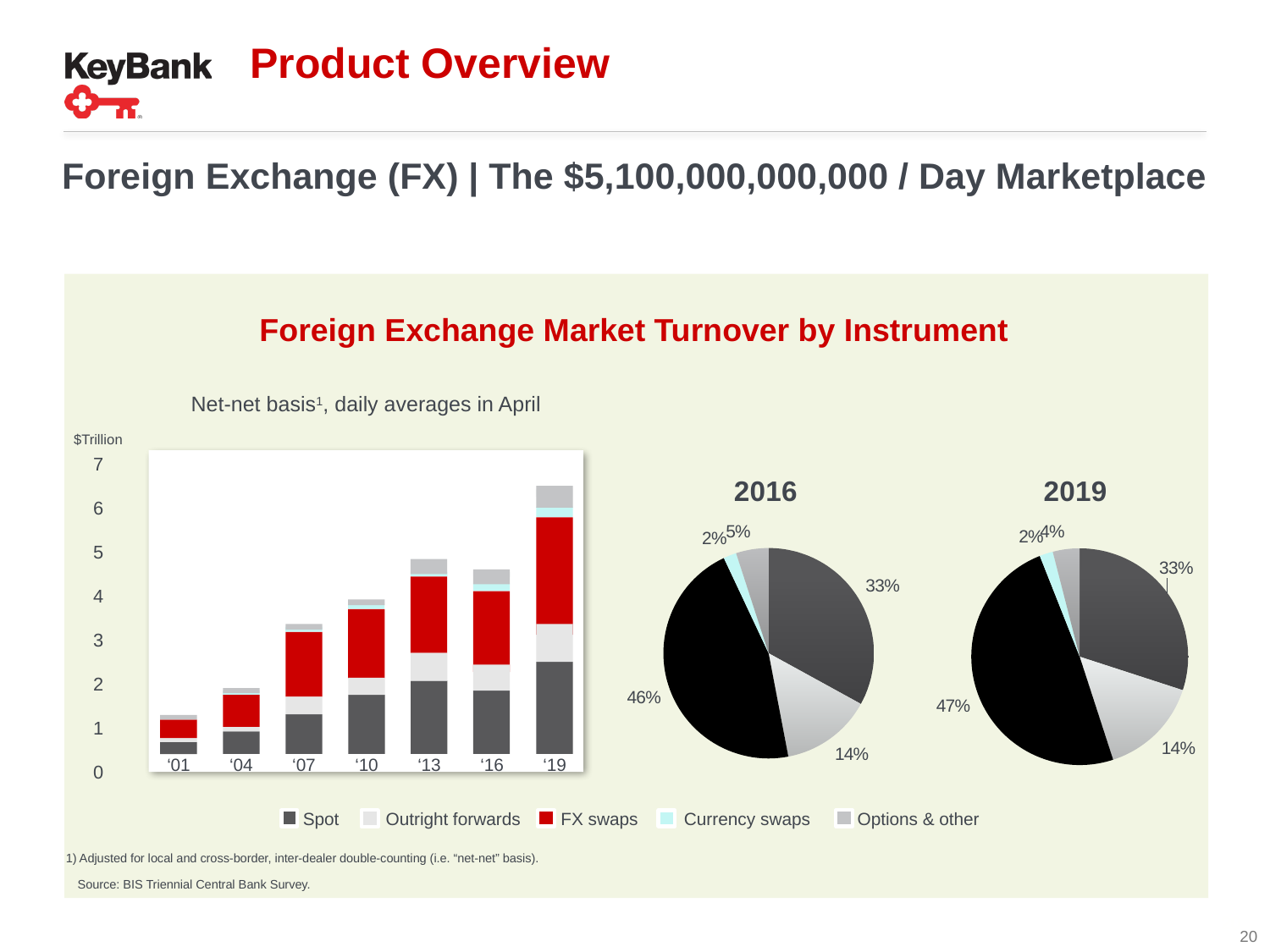
Which series in the bar chart legend is shown in red? FX swaps In the 2019 pie chart, what is the smallest share shown? 2% In the bar chart, is the total turnover for '13 greater or less than 5 $Trillion? less In the 2016 pie chart, what is the largest share shown? 46% What kind of chart is the chart on the left showing turnover from '01 to '19? Stacked bar chart In the bar chart, is the total turnover for '07 greater or less than 3 $Trillion? greater How many years are shown on the x axis of the bar chart? 7 In the bar chart, which year has the highest total turnover? '19 In the bar chart, which year has the lowest total turnover? '01 In the 2016 pie chart, what is the difference in percentage points between the 46% slice and the 33% slice? 13 percentage points How many series does the legend of the bar chart list? 5 In the bar chart, is the total turnover for '19 greater or less than 6 $Trillion? greater